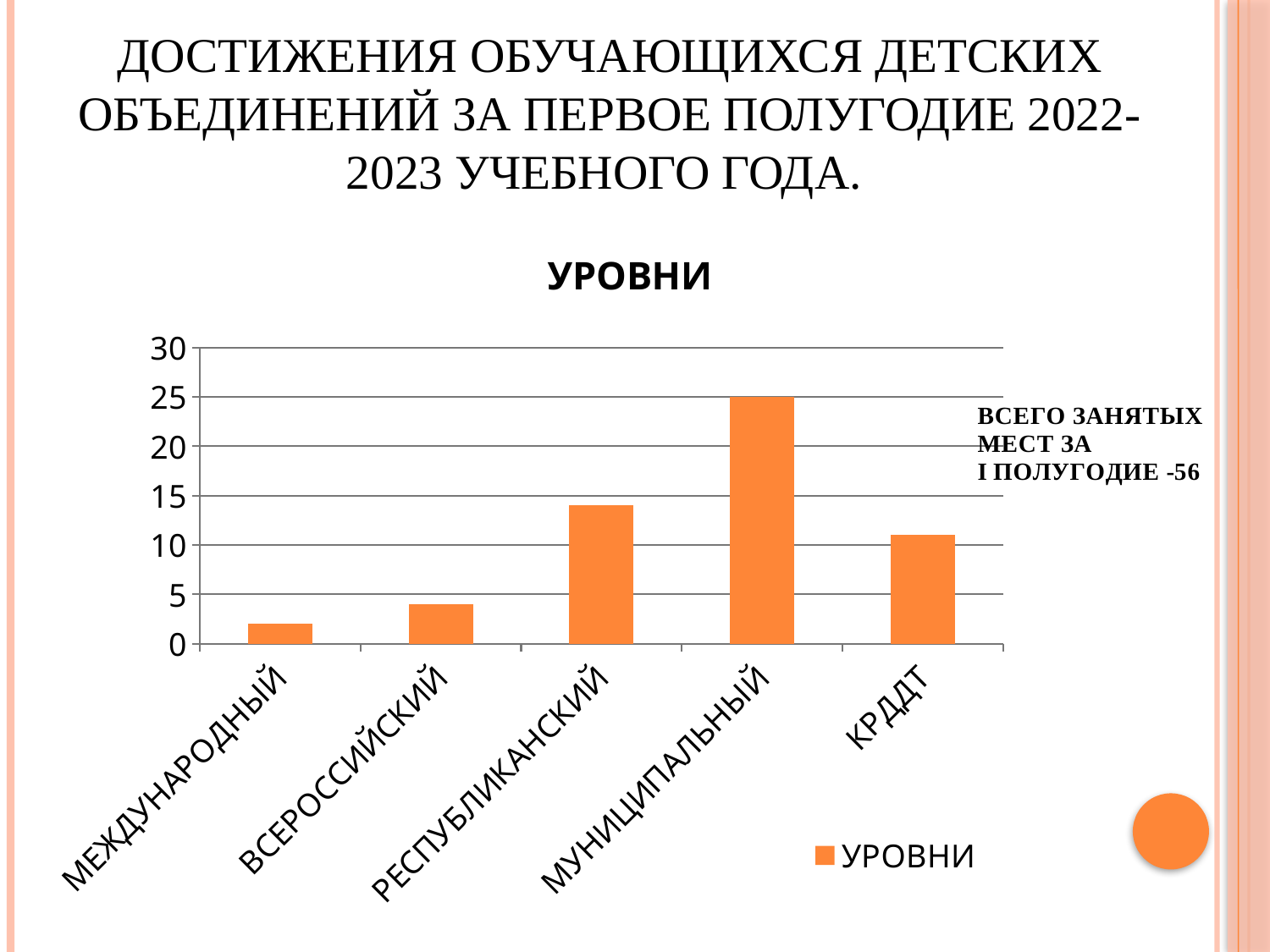
What is the value for МУНИЦИПАЛЬНЫЙ? 25 Which category has the highest value? МУНИЦИПАЛЬНЫЙ Is the value for КРДДТ greater or less than 15? less According to the text next to the chart, what is the total number of places taken in the first half-year? 56 What is the title of the chart? УРОВНИ Is the value for ВСЕРОССИЙСКИЙ greater or less than 5? less Is the value for РЕСПУБЛИКАНСКИЙ greater or less than 10? greater How many series does the legend list? 1 How many categories are shown on the x axis of the chart? 5 Which is larger, the value for РЕСПУБЛИКАНСКИЙ or the value for КРДДТ? РЕСПУБЛИКАНСКИЙ Which category has the lowest value? МЕЖДУНАРОДНЫЙ What kind of chart is shown on the slide? bar chart